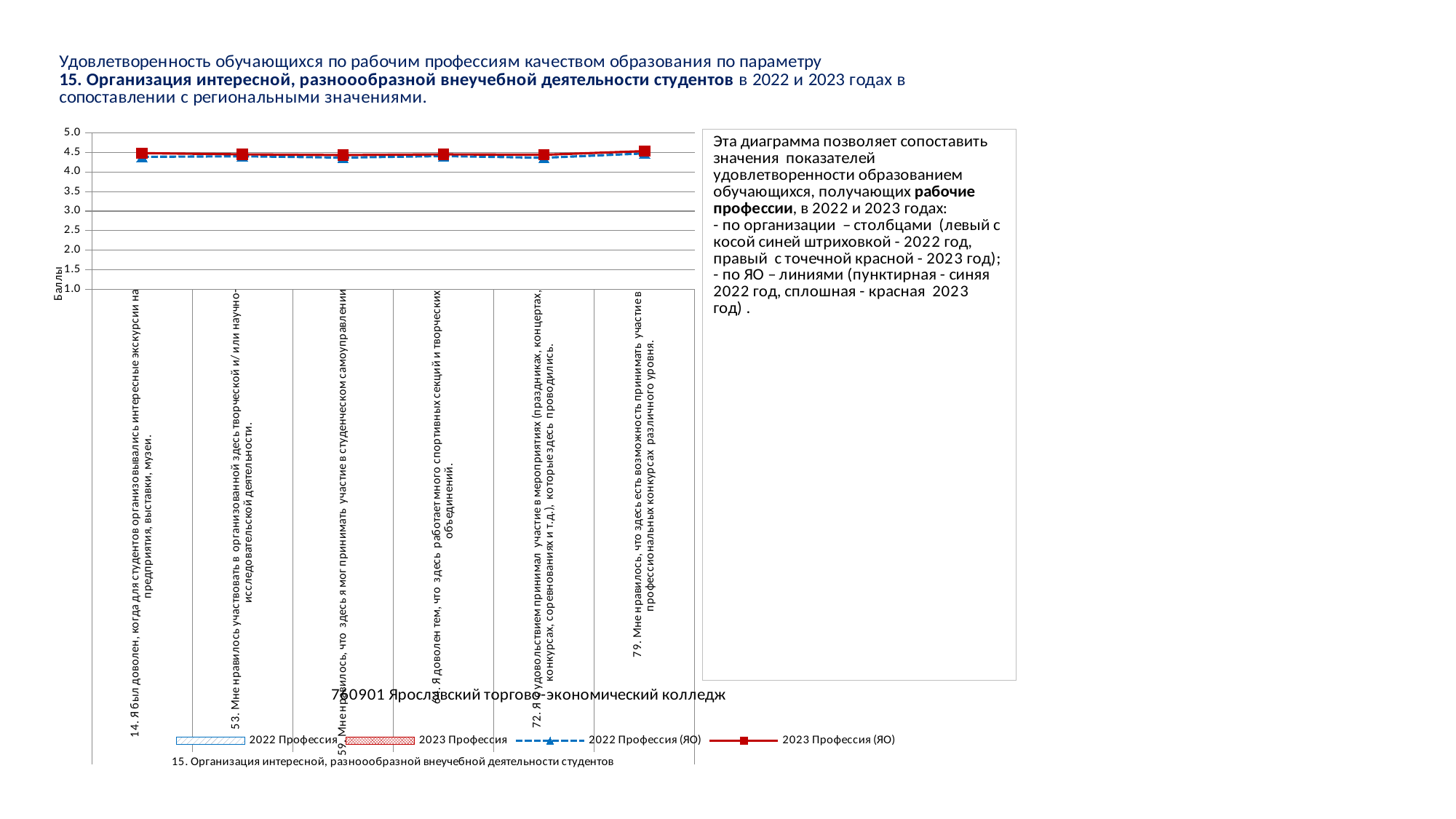
Which legend entry is drawn as a dashed blue line with triangle markers? 2022 Профессия (ЯО) How many categories are shown along the x axis? 6 What is the highest value shown on the y axis? 5.0 What is the label of the y axis? Баллы How many series does the legend list? 4 Is the value of the 2023 Профессия (ЯО) line for category 79 greater or less than 4.0? greater Is the value of the 2023 Профессия (ЯО) line for category 53 greater or less than 3.5? greater Is the value of the 2022 Профессия (ЯО) line for category 14 greater or less than 5.0? less